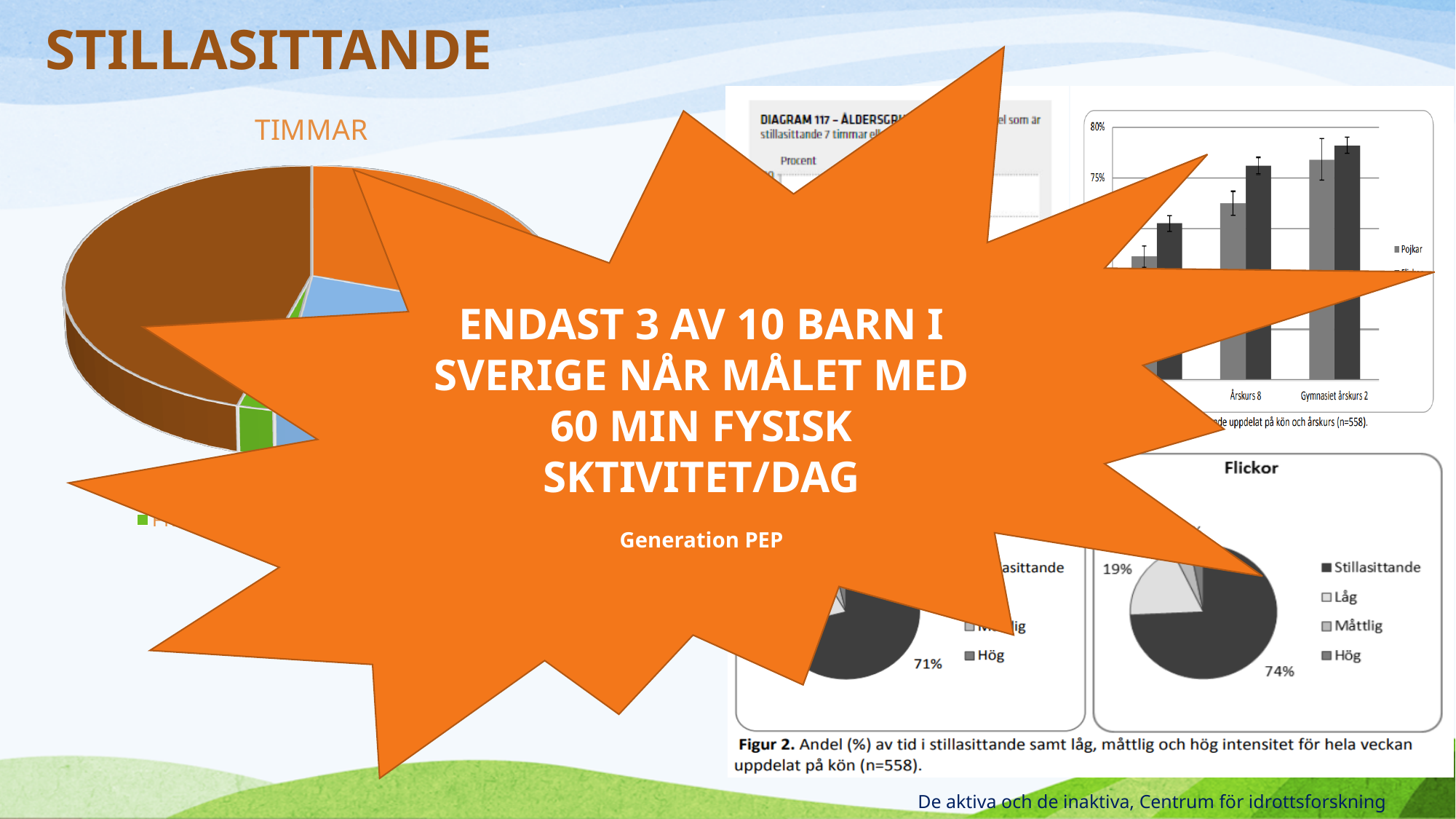
What kind of chart is the chart in the top right of the slide with the categories Årskurs 8 and Gymnasiet årskurs 2? Bar chart What is the difference between the 74% slice in the "Flickor" pie chart and the 71% slice in the pie chart to its left? 3 percentage points In the pie chart titled "Flickor", what is the value for Låg? 19% In the bar chart in the top right of the slide, is the Pojkar value for Årskurs 8 greater or less than 75%? less How many entries does the legend of the pie chart titled "Flickor" list? 4 In the pie chart titled "Flickor", which category has the largest slice? Stillasittande In the pie chart at the bottom centre of the slide (left of the "Flickor" chart), what value is printed on the largest slice? 71% What kind of chart is the chart titled "TIMMAR" on the left of the slide? Pie chart In the pie chart titled "Flickor", what is the value for Stillasittande? 74% Which is larger: the largest slice in the "Flickor" pie chart (74%) or the largest slice in the pie chart to its left (71%)? Flickor (74%) What kind of chart is the chart titled "Flickor"? Pie chart In the bar chart in the top right of the slide, is the Pojkar value for Gymnasiet årskurs 2 greater or less than 75%? greater